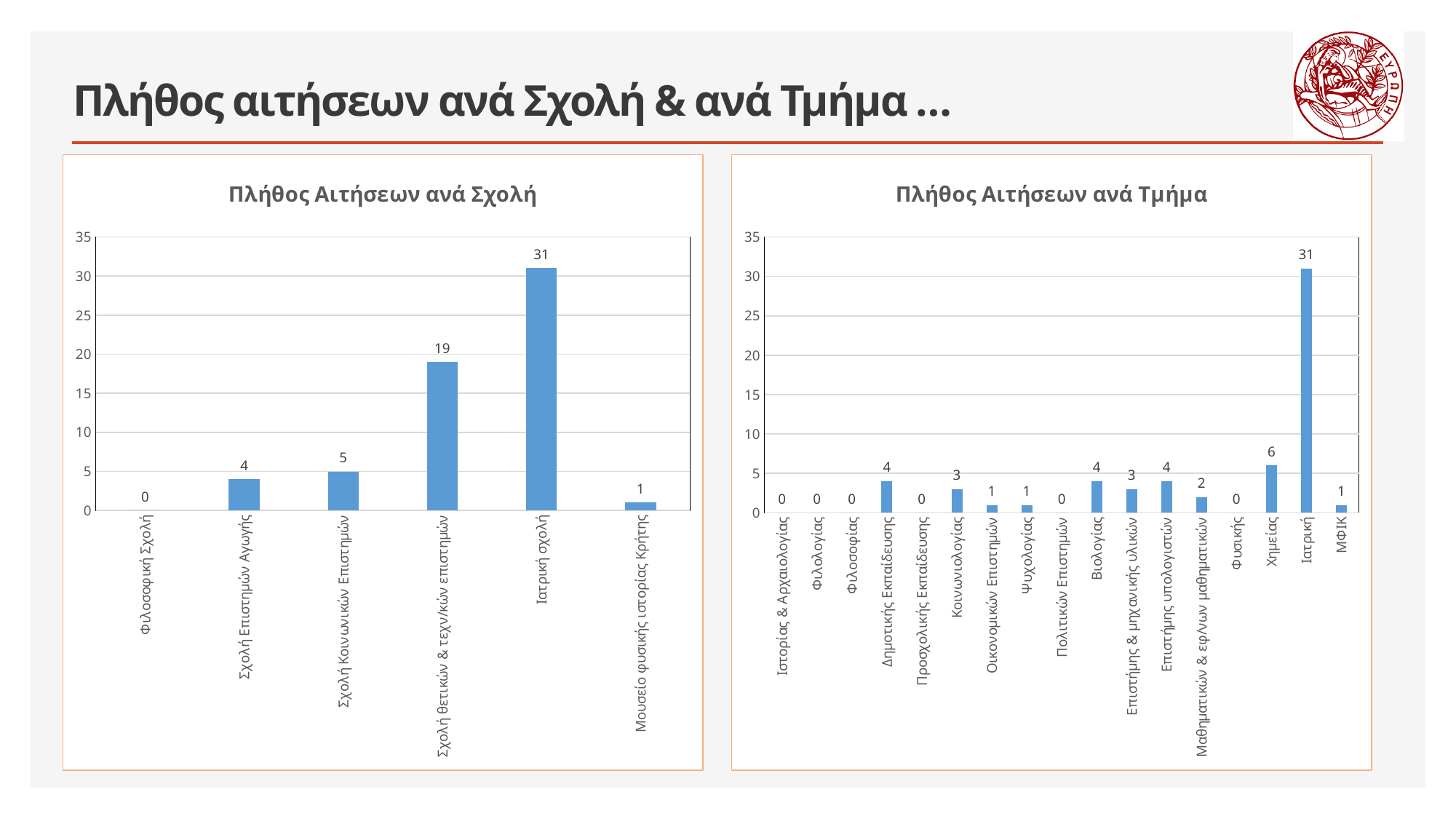
In the chart 'Πλήθος Αιτήσεων ανά Τμήμα', what is the value for Μαθηματικών & εφ/νων μαθηματικών? 2 In the chart 'Πλήθος Αιτήσεων ανά Τμήμα', what is the difference between Χημείας and Κοινωνιολογίας? 3 In the chart 'Πλήθος Αιτήσεων ανά Σχολή', what is the value for Σχολή Θετικών & τεχν/κών επιστημών? 19 In the chart 'Πλήθος Αιτήσεων ανά Σχολή', which is larger: Σχολή Επιστημών Αγωγής or Σχολή Κοινωνικών Επιστημών? Σχολή Κοινωνικών Επιστημών In the chart 'Πλήθος Αιτήσεων ανά Τμήμα', what is the value for Χημείας? 6 In the chart 'Πλήθος Αιτήσεων ανά Τμήμα', which category has the highest value? Ιατρική In the chart 'Πλήθος Αιτήσεων ανά Σχολή', how many categories are shown on the x axis? 6 In the chart 'Πλήθος Αιτήσεων ανά Σχολή', what is the value for Ιατρική σχολή? 31 In the chart 'Πλήθος Αιτήσεων ανά Σχολή', which category has the lowest value? Φιλοσοφική Σχολή What type of chart is 'Πλήθος Αιτήσεων ανά Τμήμα'? Bar chart In the chart 'Πλήθος Αιτήσεων ανά Σχολή', what is the difference between Ιατρική σχολή and Σχολή Θετικών & τεχν/κών επιστημών? 12 In the chart 'Πλήθος Αιτήσεων ανά Τμήμα', how many categories are shown on the x axis? 17